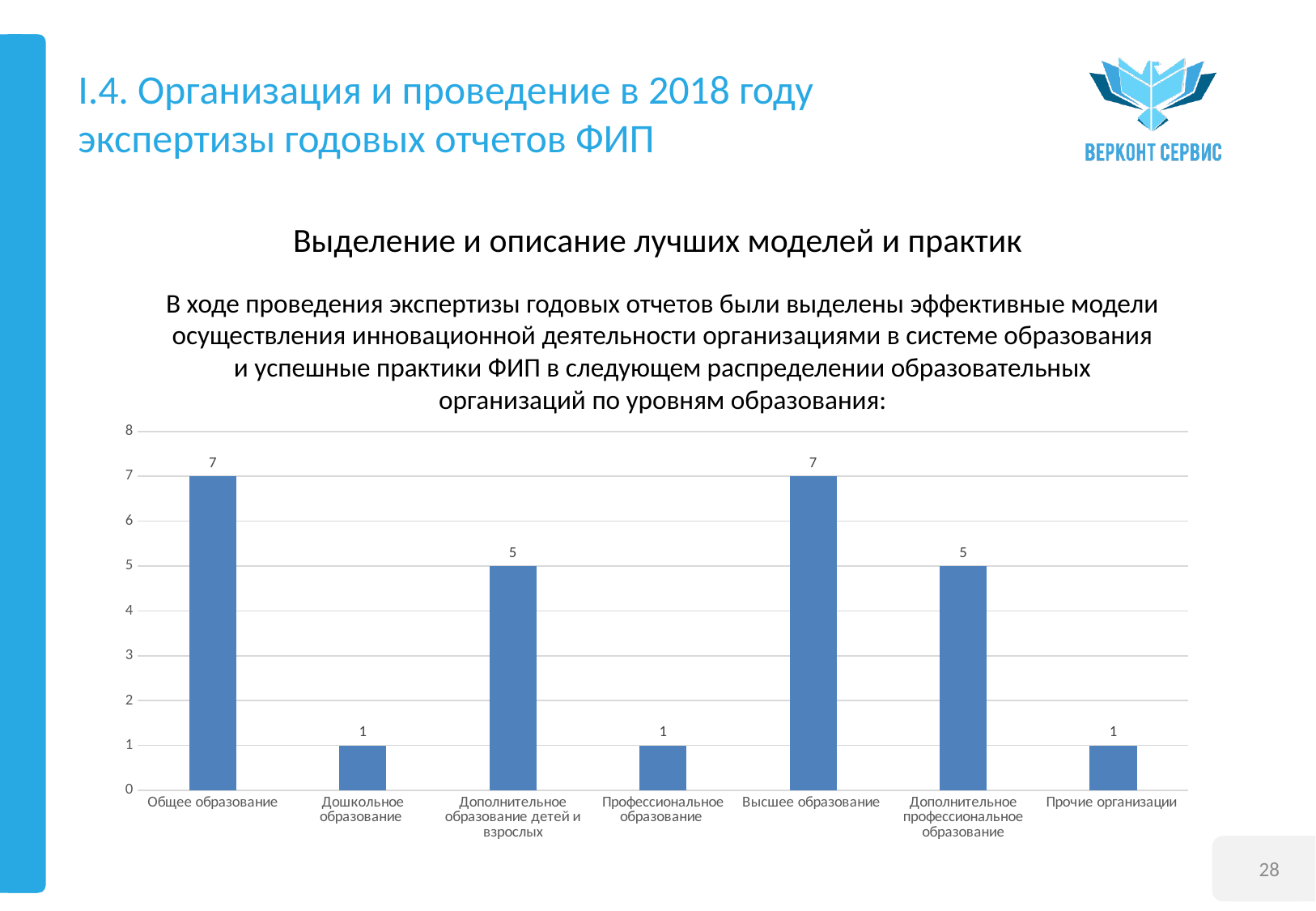
What is the value for Общее образование? 7 How many categories are shown on the x axis of the chart? 7 Which is larger, the value for Дополнительное образование детей и взрослых or the value for Дошкольное образование? Дополнительное образование детей и взрослых What is the difference between the values for Высшее образование and Профессиональное образование? 6 What is the value for Дошкольное образование? 1 What is the value for Высшее образование? 7 What is the highest value shown on the vertical axis of the chart? 8 Which is larger, the value for Высшее образование or the value for Дополнительное профессиональное образование? Высшее образование What is the difference between the values for Общее образование and Дополнительное профессиональное образование? 2 What is the value for Дополнительное образование детей и взрослых? 5 What is the value for Прочие организации? 1 What kind of chart is shown on the slide? bar chart